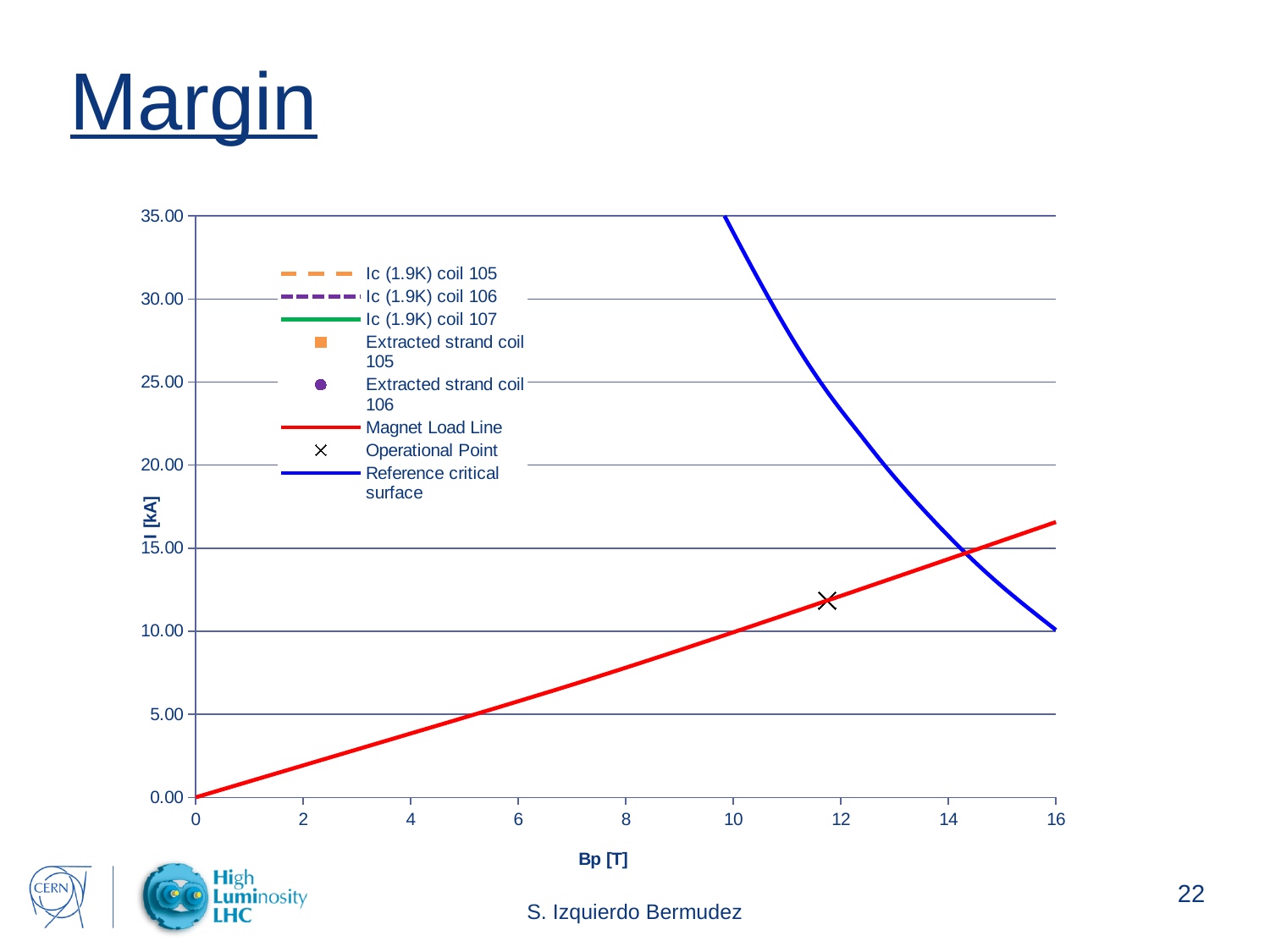
What is the label of the x axis? Bp [T] Is the Reference critical surface value at Bp = 12 greater or less than 20? greater At Bp = 12, which is higher: the Reference critical surface or the Magnet Load Line? Reference critical surface What is the label of the y axis? I [kA] Is the Magnet Load Line value at Bp = 4 greater or less than 5? less What kind of chart is shown on the slide? line chart Is the current at the Operational Point greater or less than 15 kA? less Does the Magnet Load Line rise or fall as Bp increases? rises How many entries does the chart legend list? 8 Does the Reference critical surface curve rise or fall as Bp increases? falls